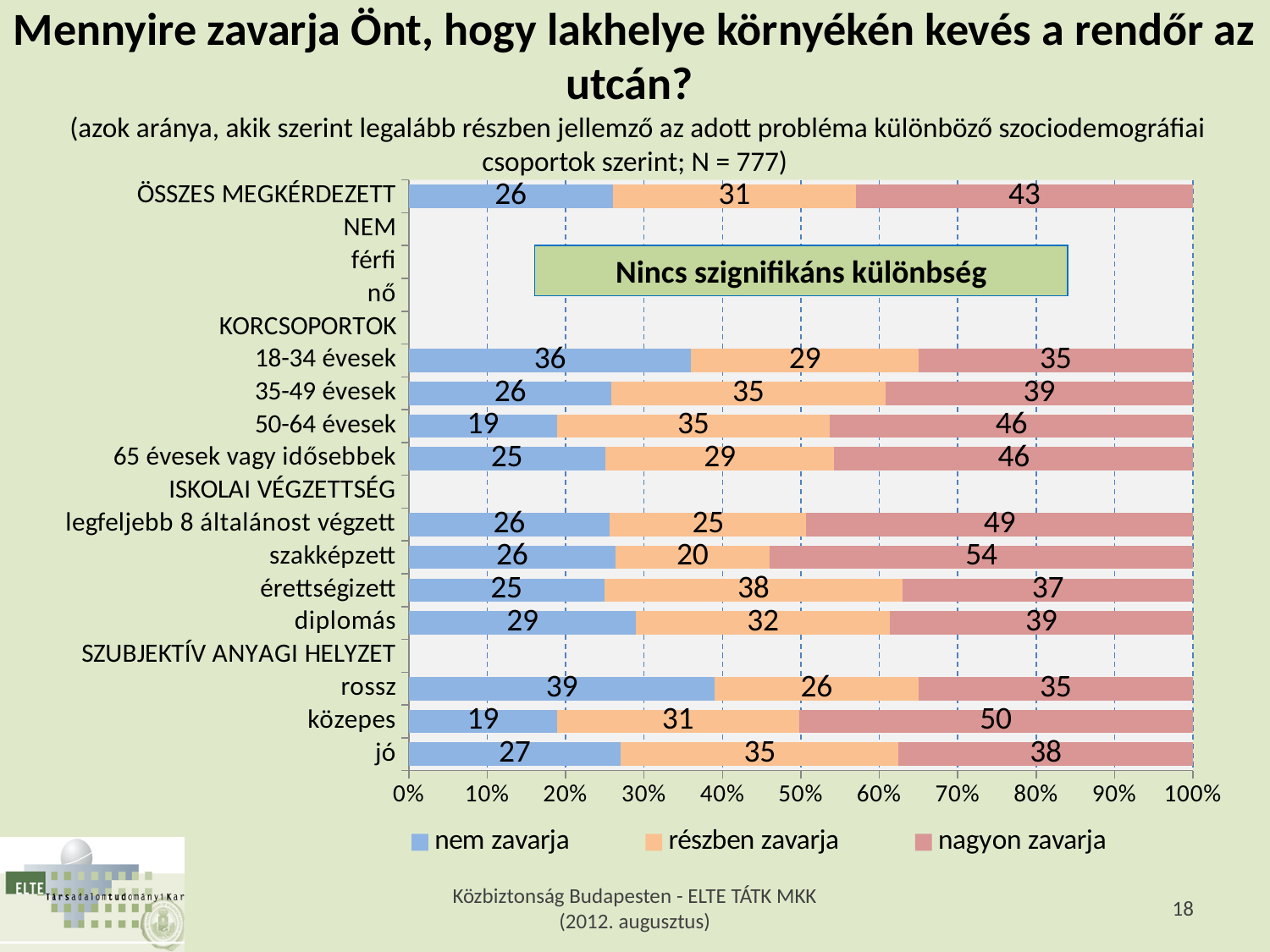
What is the difference between the "nagyon zavarja" values for közepes and rossz? 15 What is the value of "nem zavarja" for the 18-34 évesek group? 36 Which is larger: the "nem zavarja" value for rossz or for jó? rossz What is the value of "nem zavarja" for 50-64 évesek? 19 What is the value of "nagyon zavarja" for ÖSSZES MEGKÉRDEZETT? 43 What is the total of the stacked bar for diplomás? 100 Which category has the highest "nagyon zavarja" value? szakképzett Which category has the lowest "részben zavarja" value? szakképzett What is the value of "részben zavarja" for érettségizett? 38 What text appears in the green box placed over the NEM (férfi, nő) rows? Nincs szignifikáns különbség How many series does the legend list? 3 What type of chart is shown on the slide? stacked bar chart